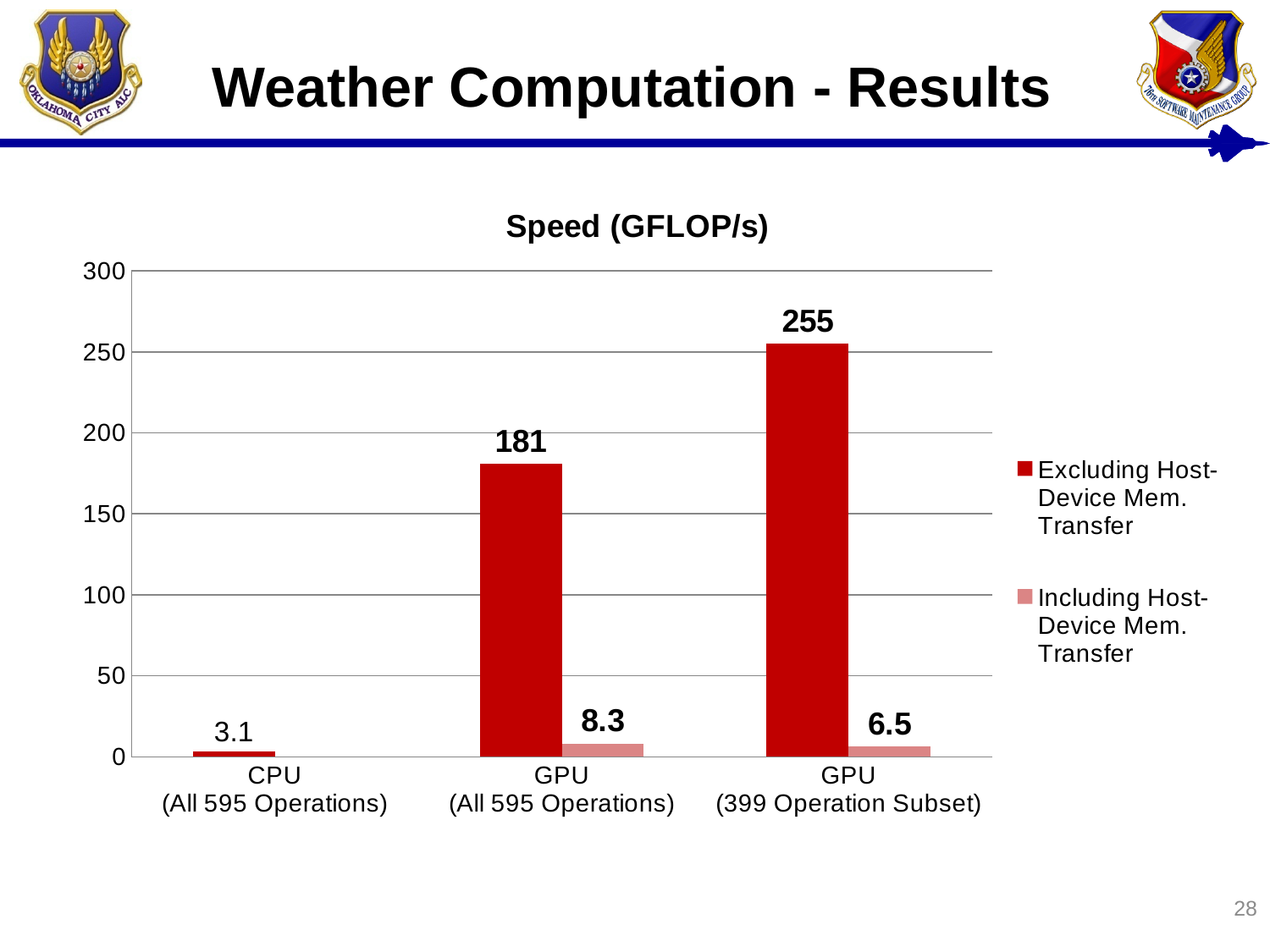
What is the speed for GPU (All 595 Operations) excluding host-device memory transfer? 181 What is the speed for GPU (All 595 Operations) including host-device memory transfer? 8.3 Which is larger, the including-transfer speed for GPU (All 595 Operations) or for GPU (399 Operation Subset)? GPU (All 595 Operations) What is the speed shown for CPU (All 595 Operations)? 3.1 What is the difference between the excluding-transfer speeds of GPU (399 Operation Subset) and GPU (All 595 Operations)? 74 How many series does the legend list? 2 Which category has the highest speed excluding host-device memory transfer? GPU (399 Operation Subset) What is the speed for GPU (399 Operation Subset) excluding host-device memory transfer? 255 How many categories are shown on the x axis? 3 What is the speed for GPU (399 Operation Subset) including host-device memory transfer? 6.5 What is the title of the chart? Speed (GFLOP/s) What kind of chart is shown on the slide? Bar chart